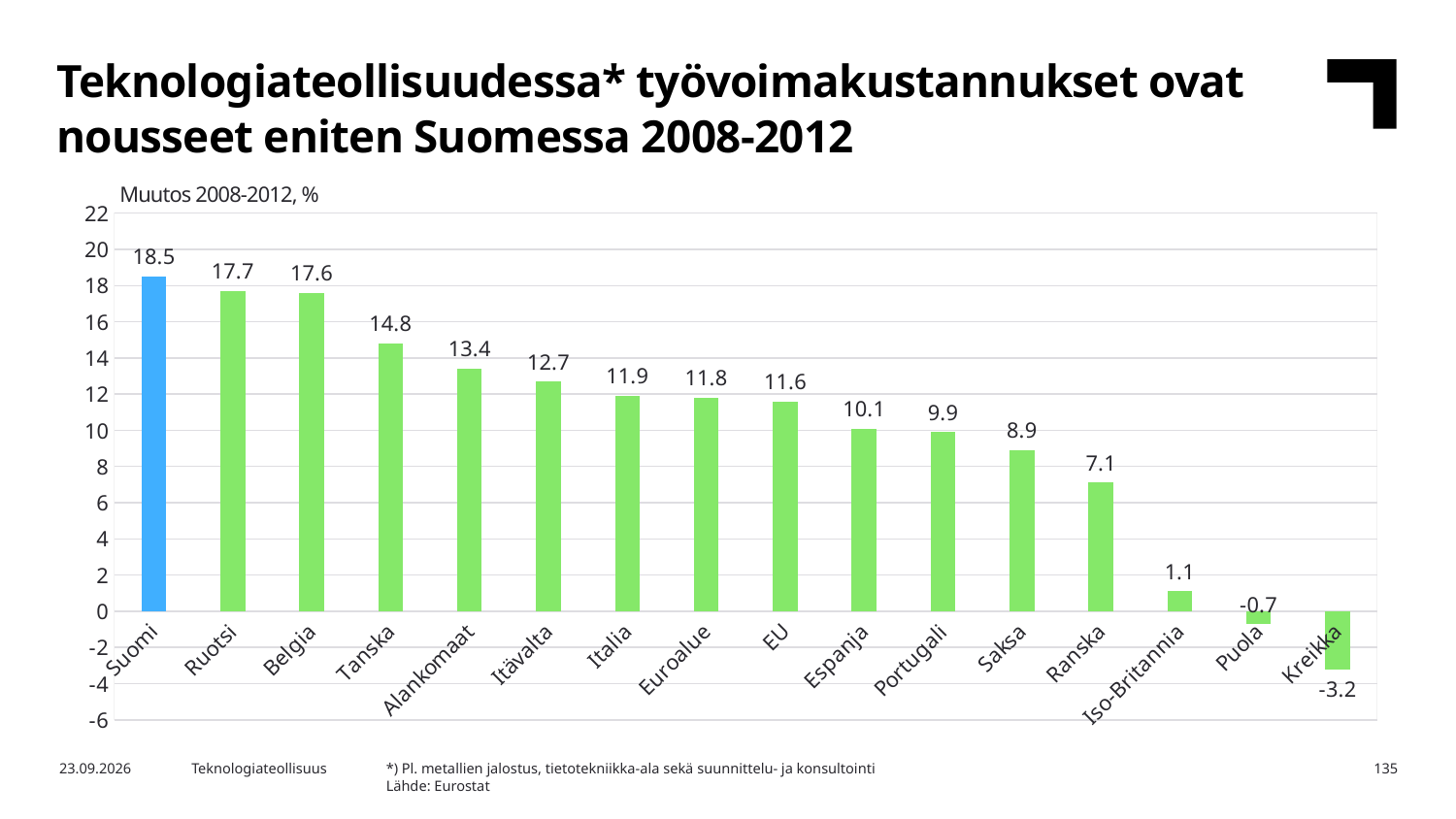
What is the value for Kreikka? -3.2 What is the value for Iso-Britannia? 1.1 What is the value for Alankomaat? 13.4 Which country has the lowest value? Kreikka Which country has the highest value? Suomi What kind of chart is shown on the slide? Bar chart What is the difference between the values for Suomi and Saksa? 9.6 Do the values rise or fall from left to right along the x axis? Fall How many categories are shown on the x axis? 16 Which is larger, the value for Tanska or the value for Espanja? Tanska What is the value for Suomi? 18.5 Which bar is coloured differently from the others? Suomi